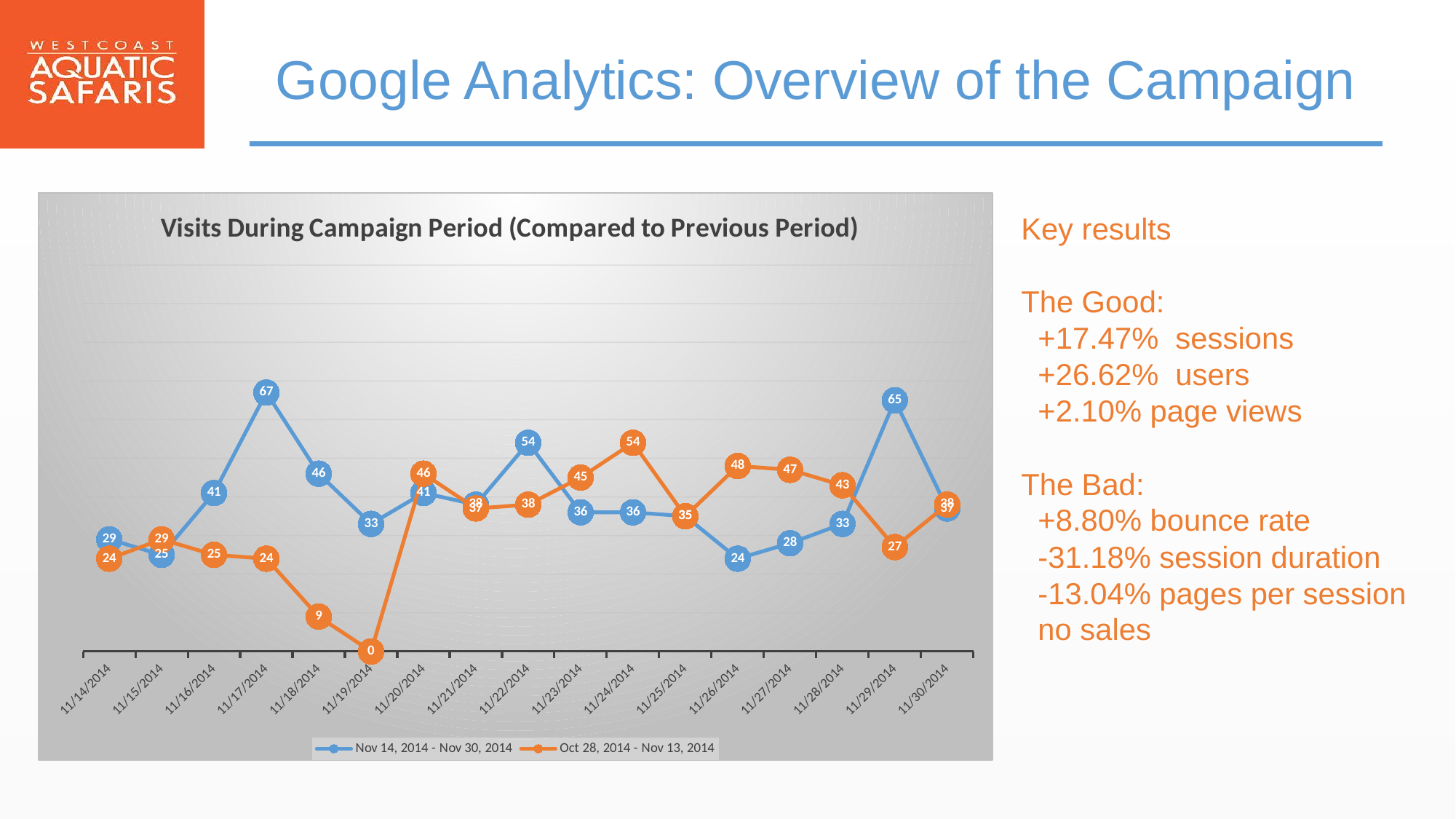
What is the value for the Nov 14, 2014 - Nov 30, 2014 series on 11/17/2014? 67 What is the difference between the two series' values on 11/26/2014? 24 What is the difference between the Nov 14, 2014 - Nov 30, 2014 values on 11/17/2014 and 11/29/2014? 2 How many series does the legend list? 2 On which date does the Nov 14, 2014 - Nov 30, 2014 series reach its highest value? 11/17/2014 How many dates are plotted along the x axis? 17 What is the value for the Oct 28, 2014 - Nov 13, 2014 series on 11/18/2014? 9 On which date does the Oct 28, 2014 - Nov 13, 2014 series reach its lowest value? 11/19/2014 On 11/24/2014, which series has the higher value? Oct 28, 2014 - Nov 13, 2014 What is the title of the chart? Visits During Campaign Period (Compared to Previous Period) What kind of chart is shown on the slide? line chart What is the value for the Oct 28, 2014 - Nov 13, 2014 series on 11/19/2014? 0